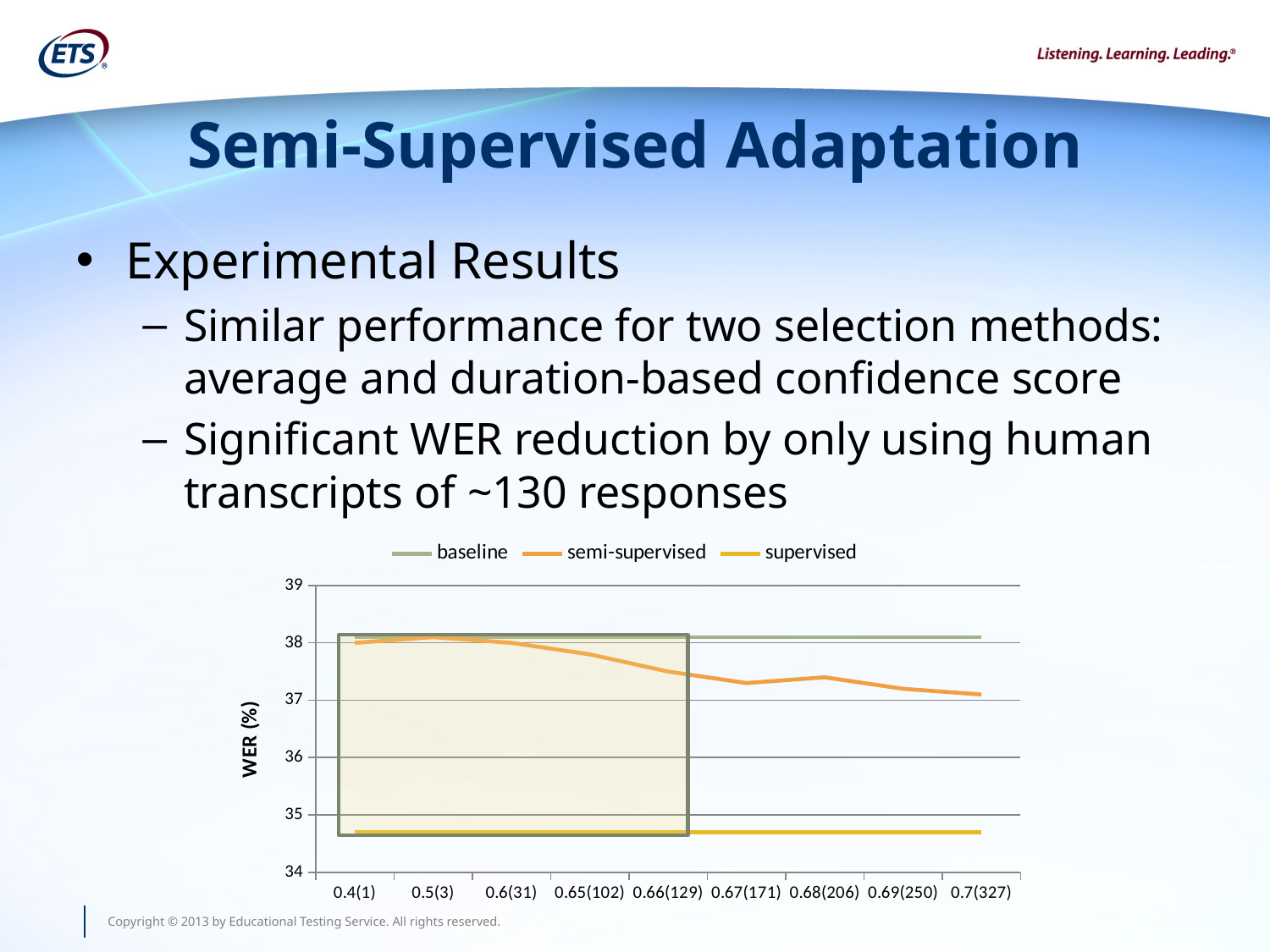
What kind of chart is shown on the slide? line chart How many series does the chart legend list? 3 Which series are listed in the chart legend? baseline, semi-supervised, supervised At 0.7(327), which is larger: the semi-supervised value or the supervised value? semi-supervised Is the semi-supervised value at 0.7(327) greater or less than 37? greater How many categories are shown along the x axis of the chart? 9 What is the label of the y axis of the chart? WER (%) Which series has the highest WER at 0.7(327)? baseline Is the value of the baseline line greater or less than 38? greater Is the value of the supervised line greater or less than 35? less Which series has the lowest WER across the chart? supervised Does the semi-supervised line rise or fall as you move from 0.4(1) to 0.7(327) along the x axis? fall